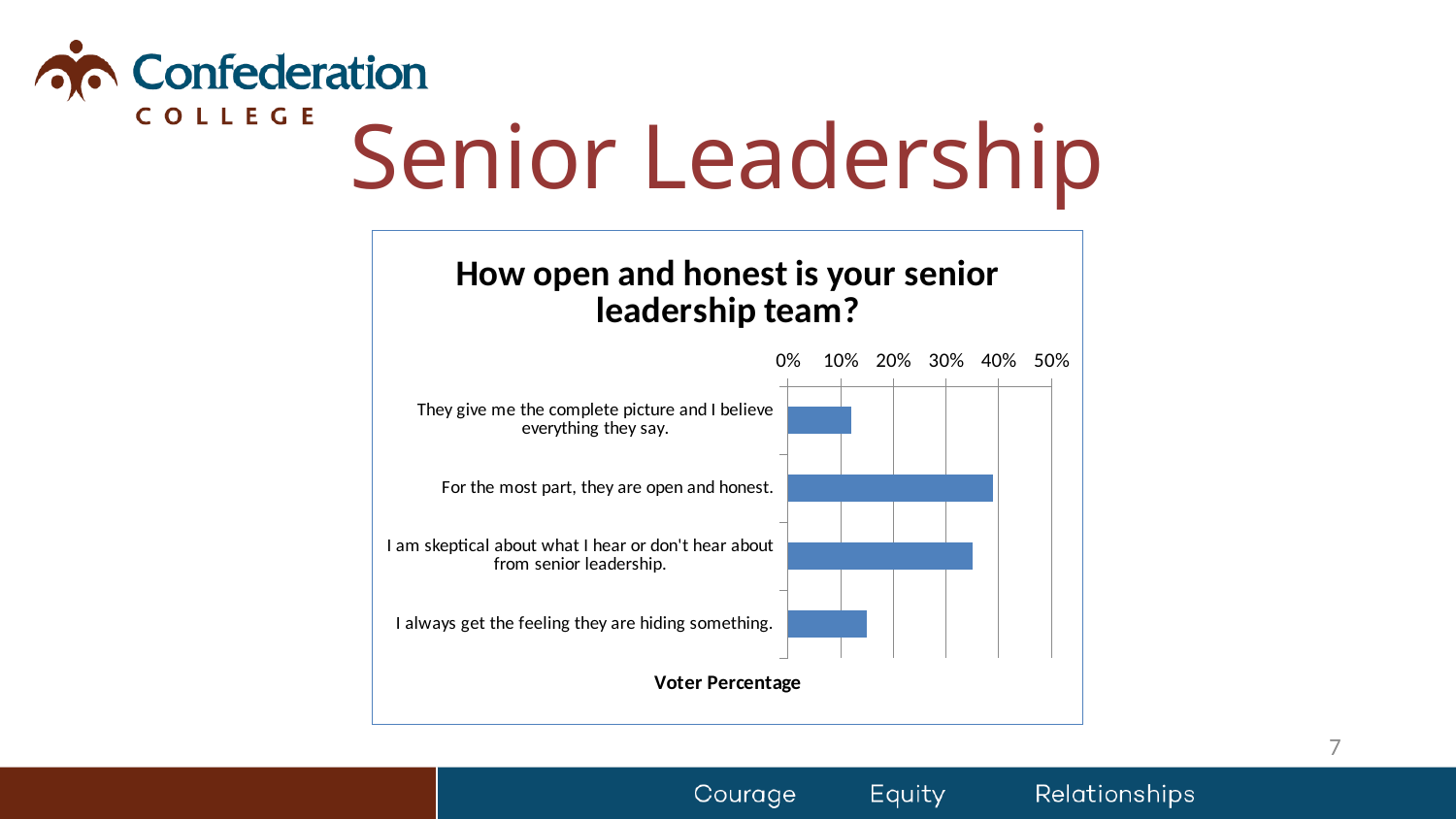
Is the value for "They give me the complete picture and I believe everything they say." greater or less than 20%? less What is the label on the value axis of the chart? Voter Percentage What is the title of the chart? How open and honest is your senior leadership team? Is the value for "For the most part, they are open and honest." greater or less than 30%? greater Which response category has the highest voter percentage? For the most part, they are open and honest. Which is larger: the value for "I am skeptical about what I hear or don't hear about from senior leadership." or the value for "I always get the feeling they are hiding something."? I am skeptical about what I hear or don't hear about from senior leadership. What kind of chart is shown on the slide? bar chart Is the value for "I am skeptical about what I hear or don't hear about from senior leadership." greater or less than 30%? greater How many response categories are plotted in the chart? 4 Which is larger: the value for "For the most part, they are open and honest." or the value for "They give me the complete picture and I believe everything they say."? For the most part, they are open and honest.